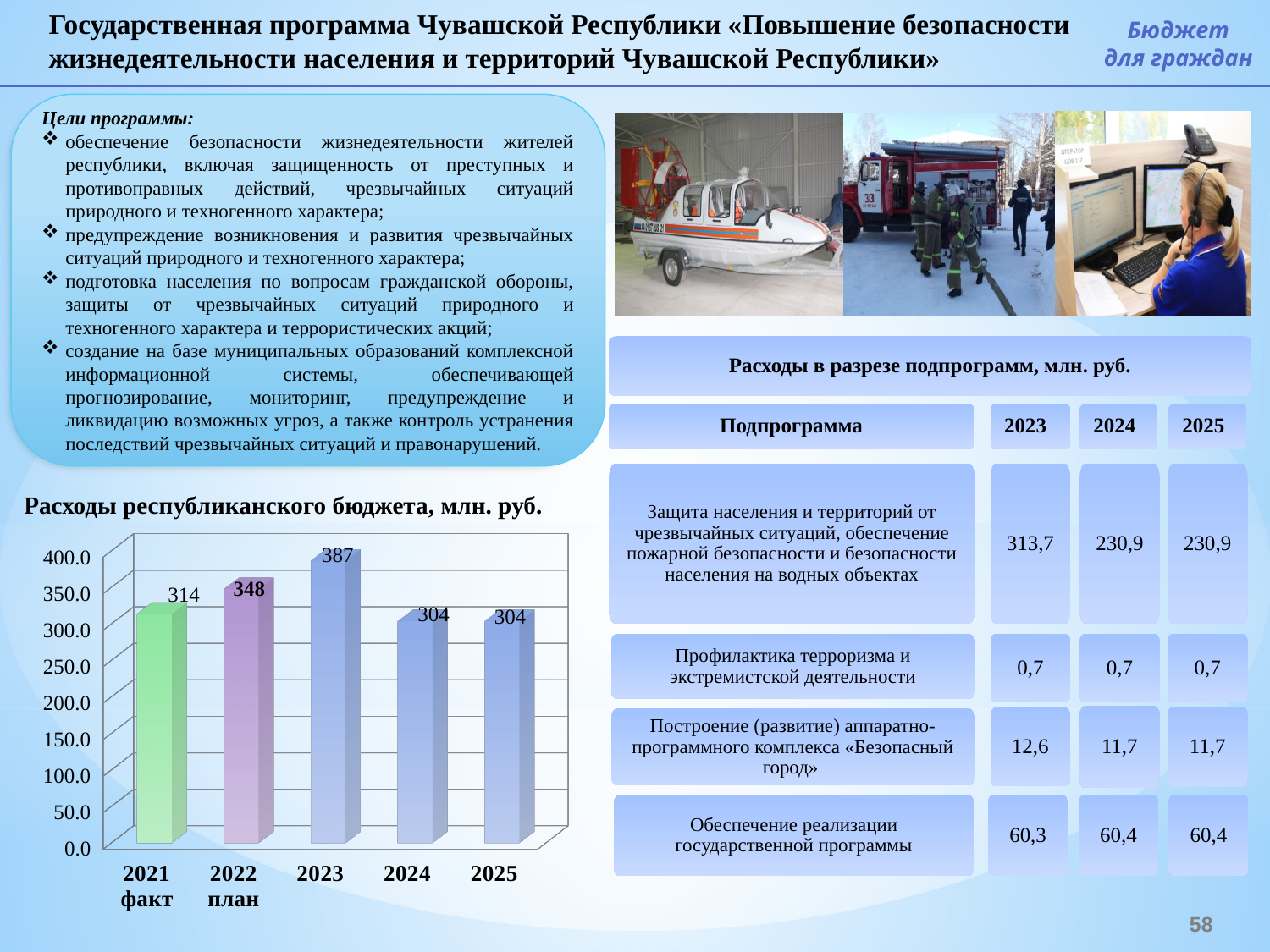
What is the difference between the values for 2022 план and 2021 факт? 34 Is the value for 2023 greater or less than 350.0? greater What is the value for 2025 in the chart? 304 Which is larger, the value for 2022 план or the value for 2024? 2022 план What is the title of the chart on the slide? Расходы республиканского бюджета, млн. руб. How many bars are shown in the chart? 5 What is the value for 2022 план in the chart? 348 Which year has the highest value in the chart? 2023 What kind of chart is shown on the slide? bar chart What is the value for 2021 факт in the chart? 314 What is the value for 2023 in the chart 'Расходы республиканского бюджета, млн. руб.'? 387 What is the difference between the values for 2023 and 2024? 83